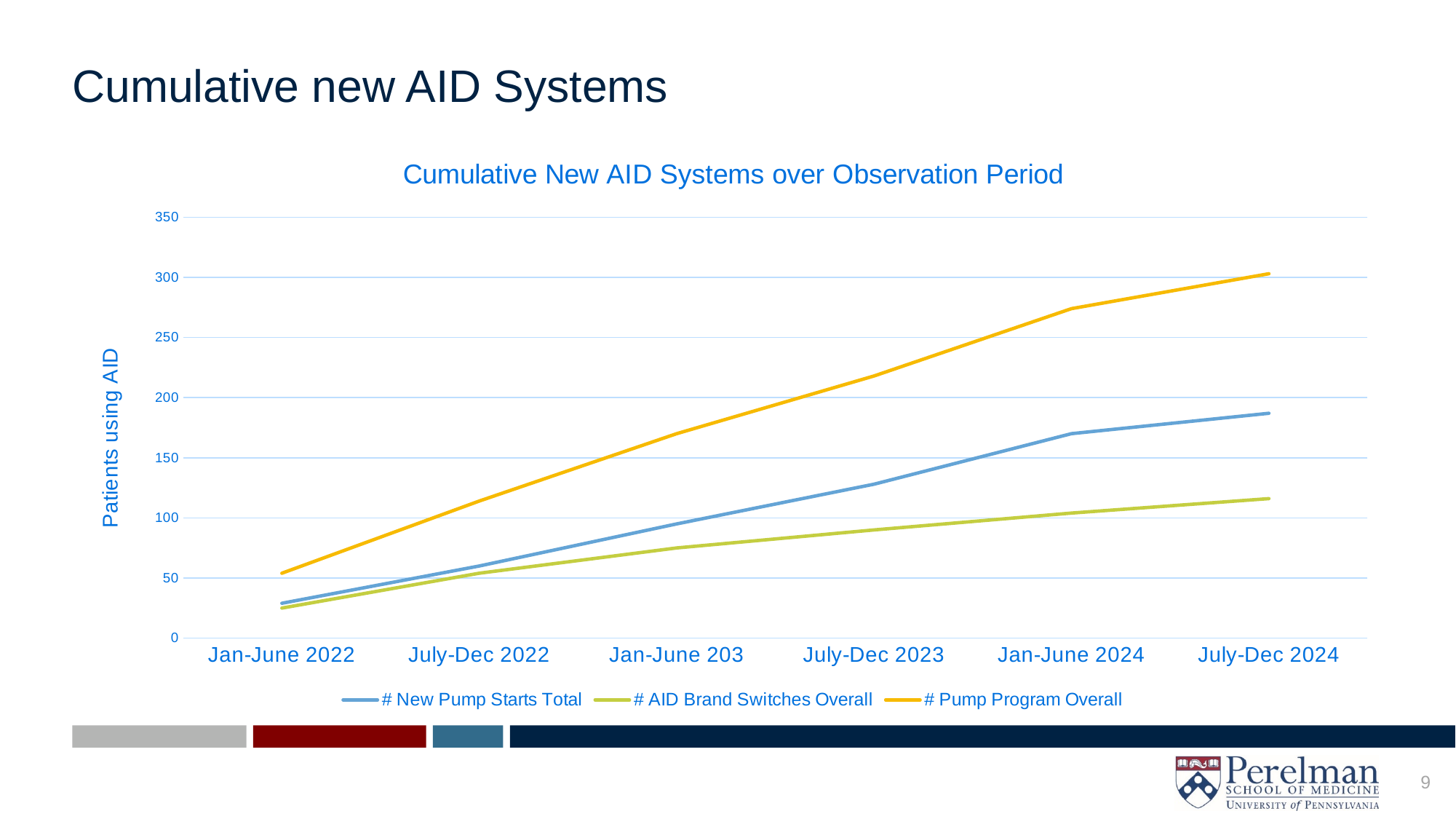
Which series has the lowest value at July-Dec 2024? # AID Brand Switches Overall Do the values for # Pump Program Overall rise or fall from Jan-June 2022 to July-Dec 2024? Rise What is the label of the y axis? Patients using AID Is the value for # Pump Program Overall at July-Dec 2024 greater or less than 250? greater At July-Dec 2024, which is larger: # New Pump Starts Total or # AID Brand Switches Overall? # New Pump Starts Total Which series has the highest value at July-Dec 2024? # Pump Program Overall How many series does the legend list? 3 Is the value for # New Pump Starts Total at July-Dec 2024 greater or less than 150? greater Is the value for # New Pump Starts Total at Jan-June 2022 greater or less than 50? less What kind of chart is shown on the slide? Line chart How many time periods are shown on the x axis? 6